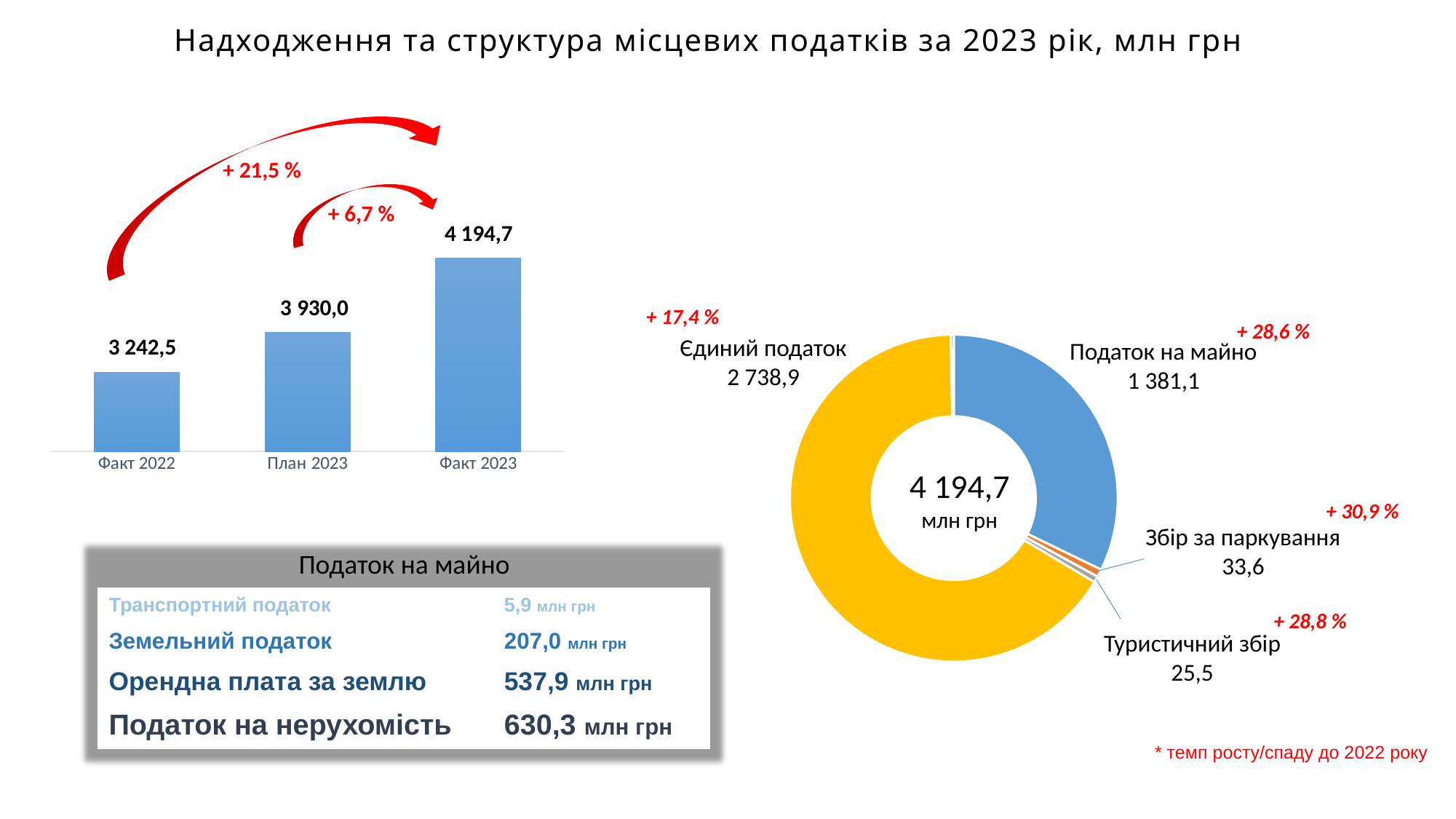
On the left bar chart, do the values rise or fall from Факт 2022 to Факт 2023? rise On the right doughnut chart, which category has the largest value? Єдиний податок How many bars are on the left bar chart? 3 On the left bar chart, what is the value for Факт 2023? 4 194,7 On the right doughnut chart, which is larger: Збір за паркування or Туристичний збір? Збір за паркування On the left bar chart, which category has the lowest value? Факт 2022 On the left bar chart, what is the value for План 2023? 3 930,0 What kind of chart is shown on the right side of the slide? doughnut chart On the left bar chart, what is the difference between Факт 2023 and План 2023? 264,7 On the right doughnut chart, what is the difference between Єдиний податок and Податок на майно? 1 357,8 On the right doughnut chart, what is the value for Податок на майно? 1 381,1 On the left bar chart, what is the difference between Факт 2023 and Факт 2022? 952,2